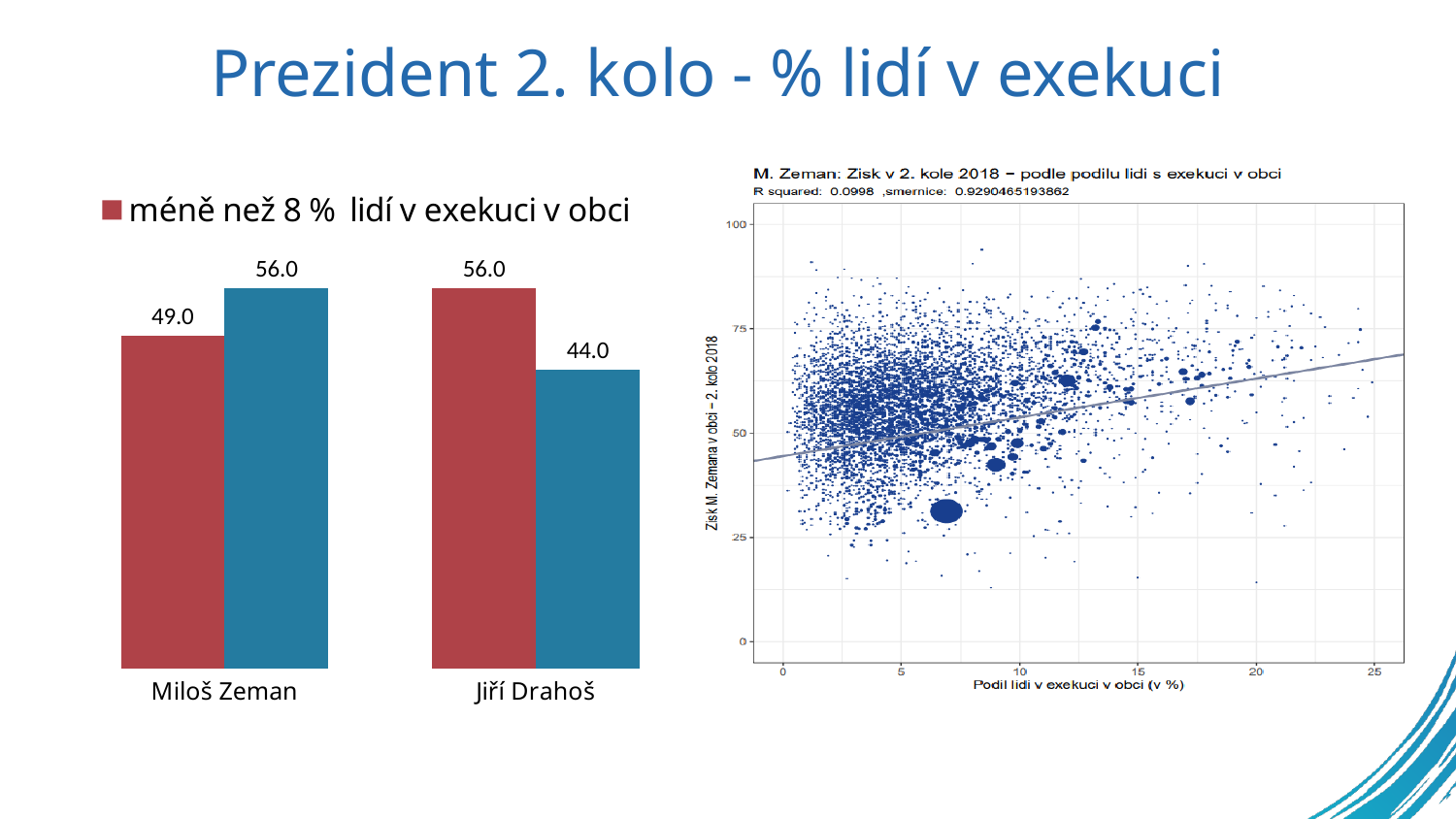
In the bar chart on the left, how much higher is Miloš Zeman's blue bar than his red bar? 7.0 In the bar chart on the left, what is the value of the blue bar for Miloš Zeman? 56.0 In the scatter plot on the right, does the fitted line rise or fall as the share of people in execution (x axis) increases? rises In the bar chart on the left, what is the value of the red bar (méně než 8 % lidí v exekuci v obci) for Miloš Zeman? 49.0 In the bar chart on the left, what is the value of the blue bar for Jiří Drahoš? 44.0 In the bar chart on the left, which of Jiří Drahoš's two bars is larger, the red one or the blue one? the red one In the scatter plot on the right, what R squared value is printed under the title? 0.0998 In the bar chart on the left, how many candidates (categories) are shown on the x axis? 2 What kind of chart is the chart on the right of the slide? scatter plot In the bar chart on the left, what is the difference between Jiří Drahoš's red bar and his blue bar? 12.0 What kind of chart is the chart on the left of the slide? bar chart In the bar chart on the left, what is the value of the red bar (méně než 8 % lidí v exekuci v obci) for Jiří Drahoš? 56.0